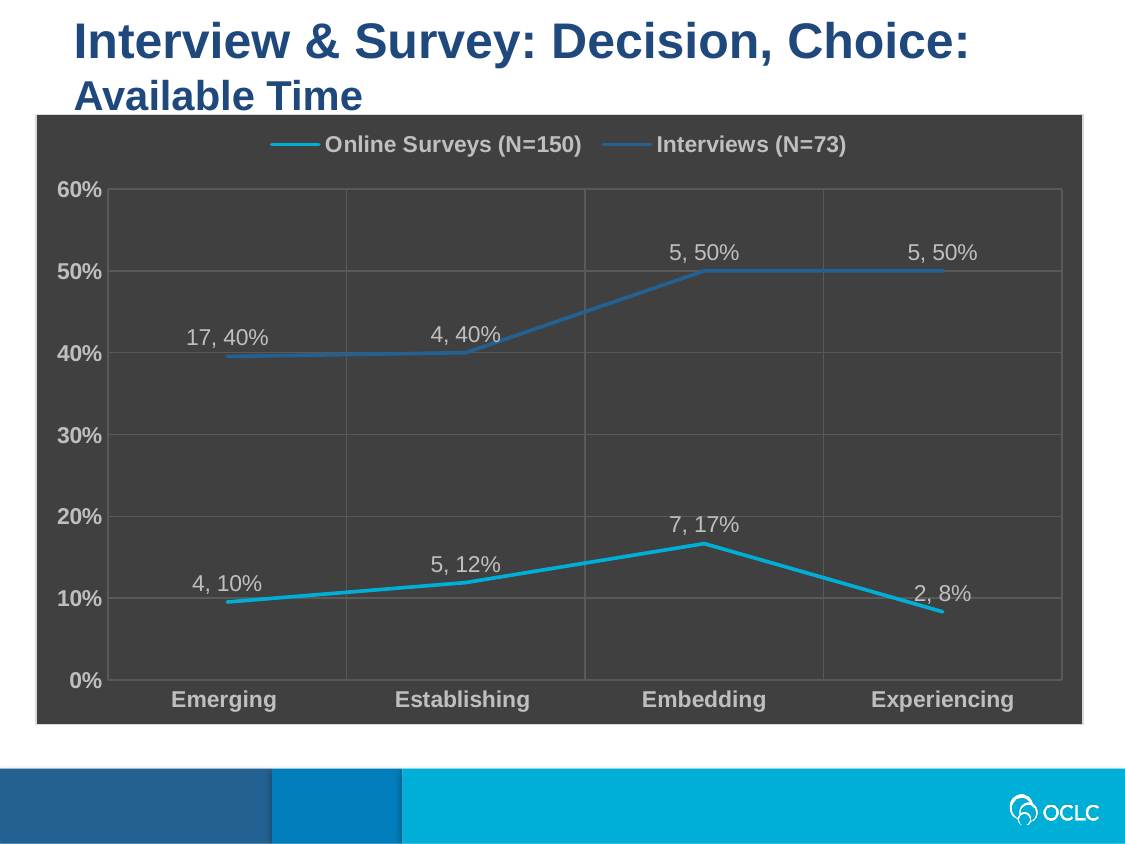
Which series has the larger percentage at Establishing, Online Surveys (N=150) or Interviews (N=73)? Interviews (N=73) What is the title of the slide? Interview & Survey: Decision, Choice: Available Time Does the Interviews (N=73) percentage rise or fall from Establishing to Embedding? rise At which category is the Online Surveys (N=150) percentage lowest? Experiencing What type of chart is shown on the slide? line chart What percentage is shown for Online Surveys (N=150) at Embedding? 17% At which category is the Online Surveys (N=150) percentage highest? Embedding How many series does the legend list? 2 What percentage is shown for Interviews (N=73) at Emerging? 40% What is the data label for Online Surveys (N=150) at Experiencing? 2, 8% What is the difference in percentage between Interviews (N=73) and Online Surveys (N=150) at Embedding? 33% How many categories are shown on the x axis? 4